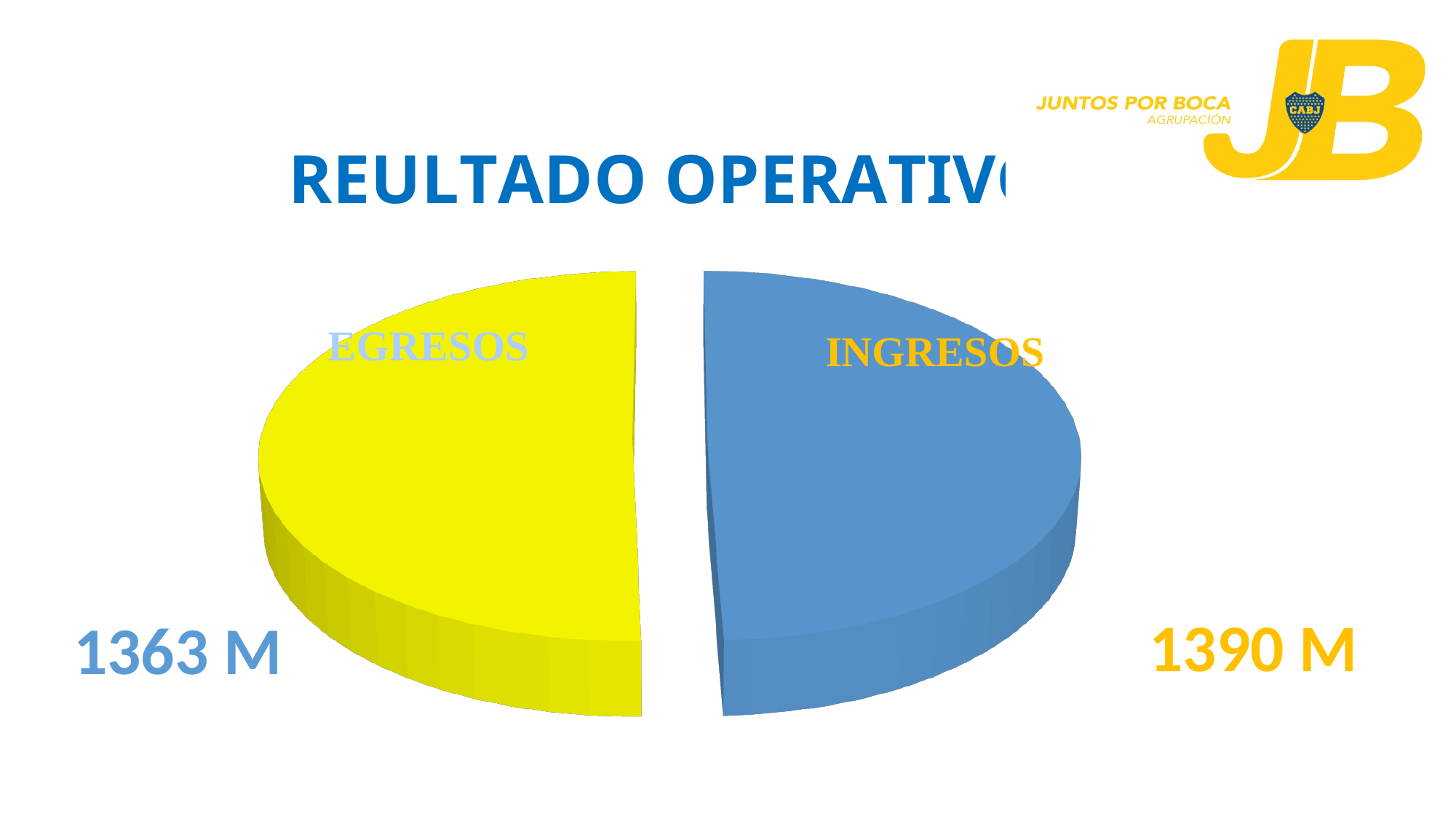
How many slices does the pie chart have? 2 What type of chart is shown on the slide? Pie chart What is the difference between the INGRESOS value and the EGRESOS value? 27 M What is the value shown for EGRESOS? 1363 M Which slice has the larger value, INGRESOS or EGRESOS? INGRESOS Which category has the lowest value in the pie chart? EGRESOS Which category has the highest value in the pie chart? INGRESOS What colour is the INGRESOS slice? Blue What is the value shown for INGRESOS? 1390 M What colour is the EGRESOS slice? Yellow